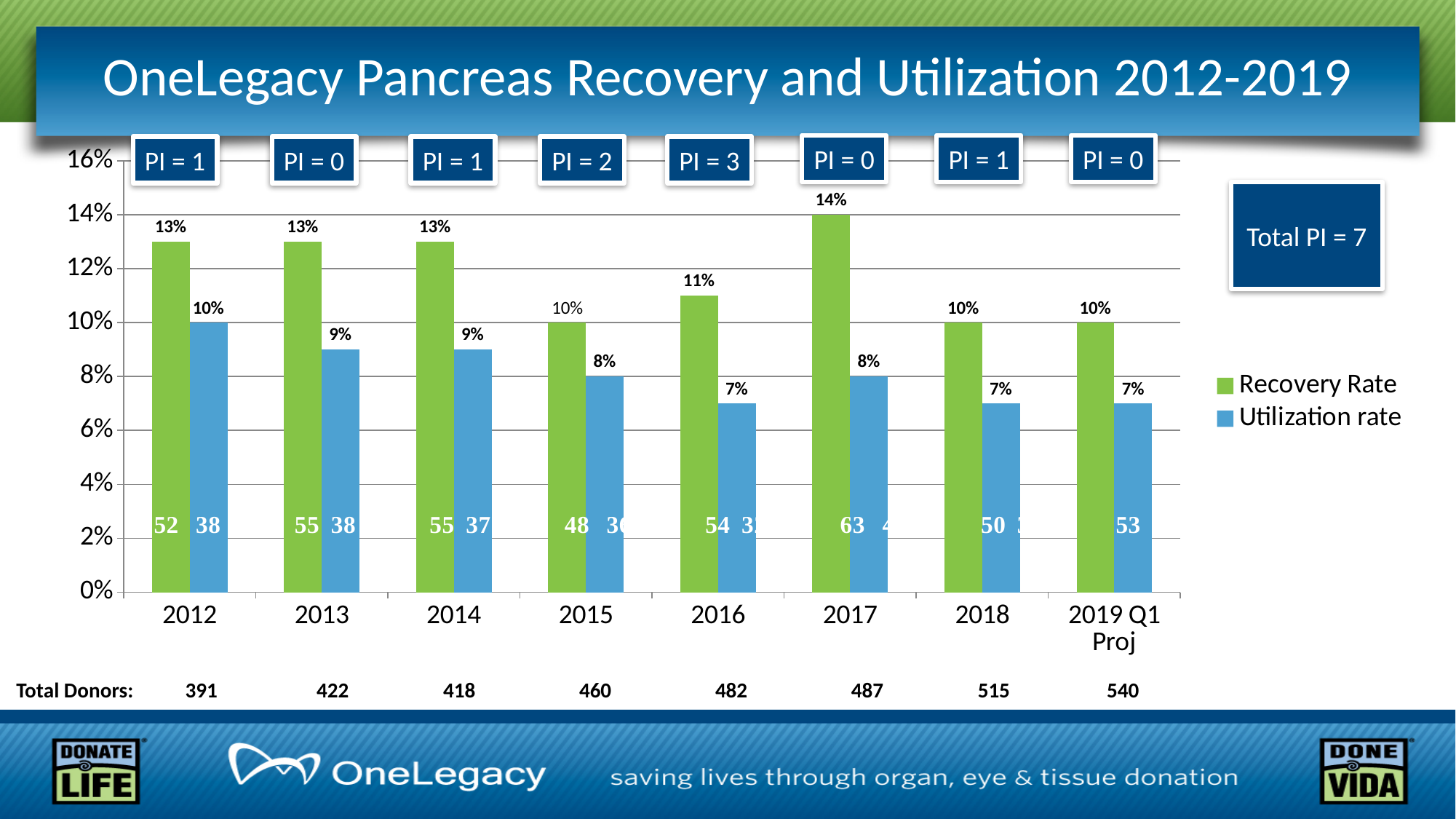
Which year has the highest Utilization rate? 2012 Which year has the larger Recovery Rate, 2015 or 2016? 2016 What kind of chart is shown on the slide? bar chart How many series does the legend list? 2 What is the number printed inside the green Recovery Rate bar for 2017? 63 What is the Recovery Rate for 2017? 14% What is the difference between the Recovery Rate and the Utilization rate in 2017? 6% What is the Total PI value shown in the box on the right of the chart? Total PI = 7 Is the Recovery Rate for 2017 greater or less than 12%? greater What is the Utilization rate for 2012? 10% Which year has the highest Recovery Rate? 2017 How many year categories are shown on the x axis? 8